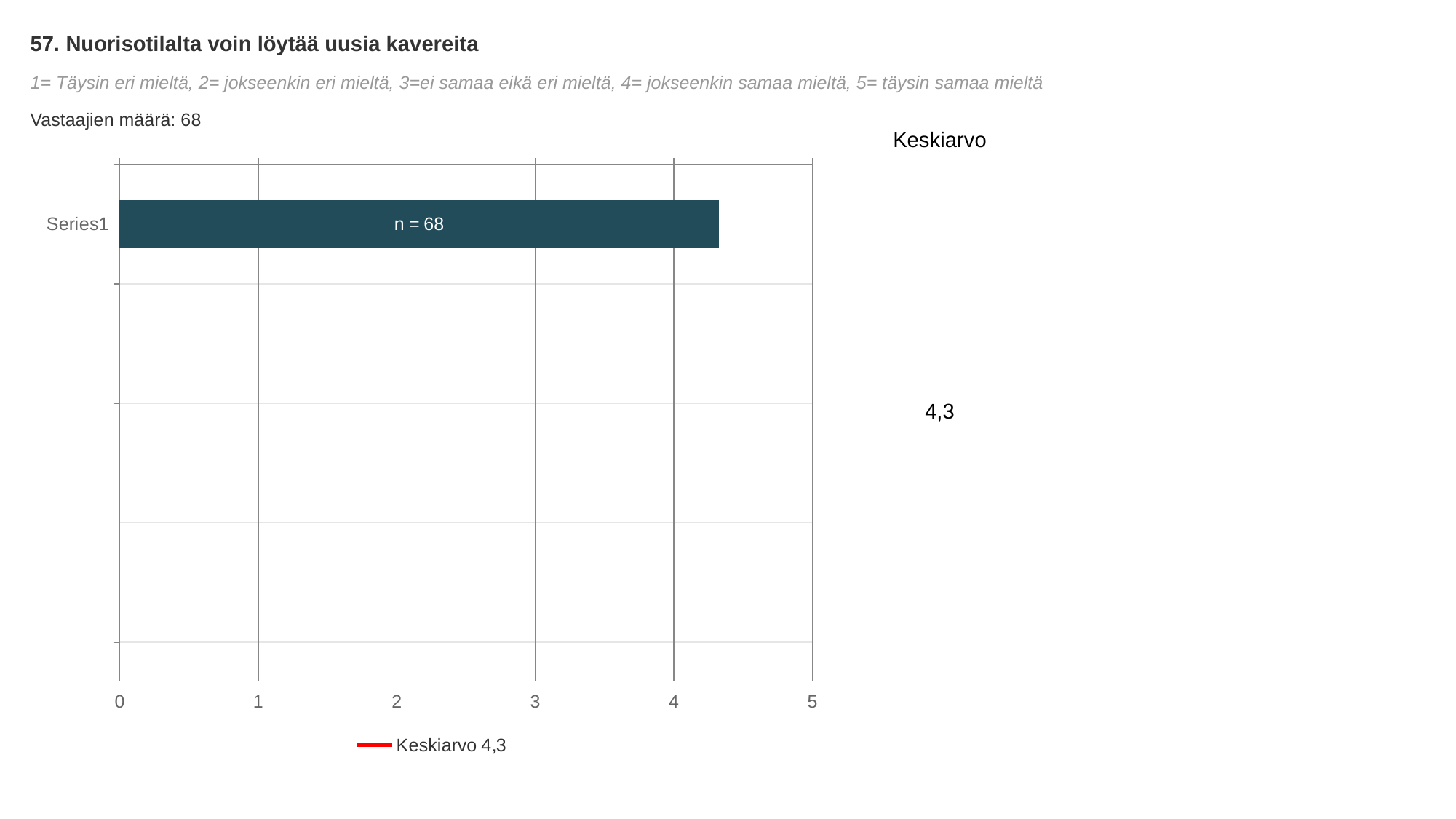
Is the value of the Series1 bar greater or less than 4? greater How many respondents (Vastaajien määrä) are reported on the slide? 68 What is the data label printed on the Series1 bar? n = 68 What is the highest value shown on the x axis? 5 What is the label of the category on the y axis? Series1 What Keskiarvo (mean) value is shown on the slide? 4,3 Is the value of the Series1 bar greater or less than 3? greater How many bars are plotted in the chart? 1 Is the value of the Series1 bar greater or less than 5? less What is the title of the chart? 57. Nuorisotilalta voin löytää uusia kavereita What kind of chart is shown on the slide? bar chart